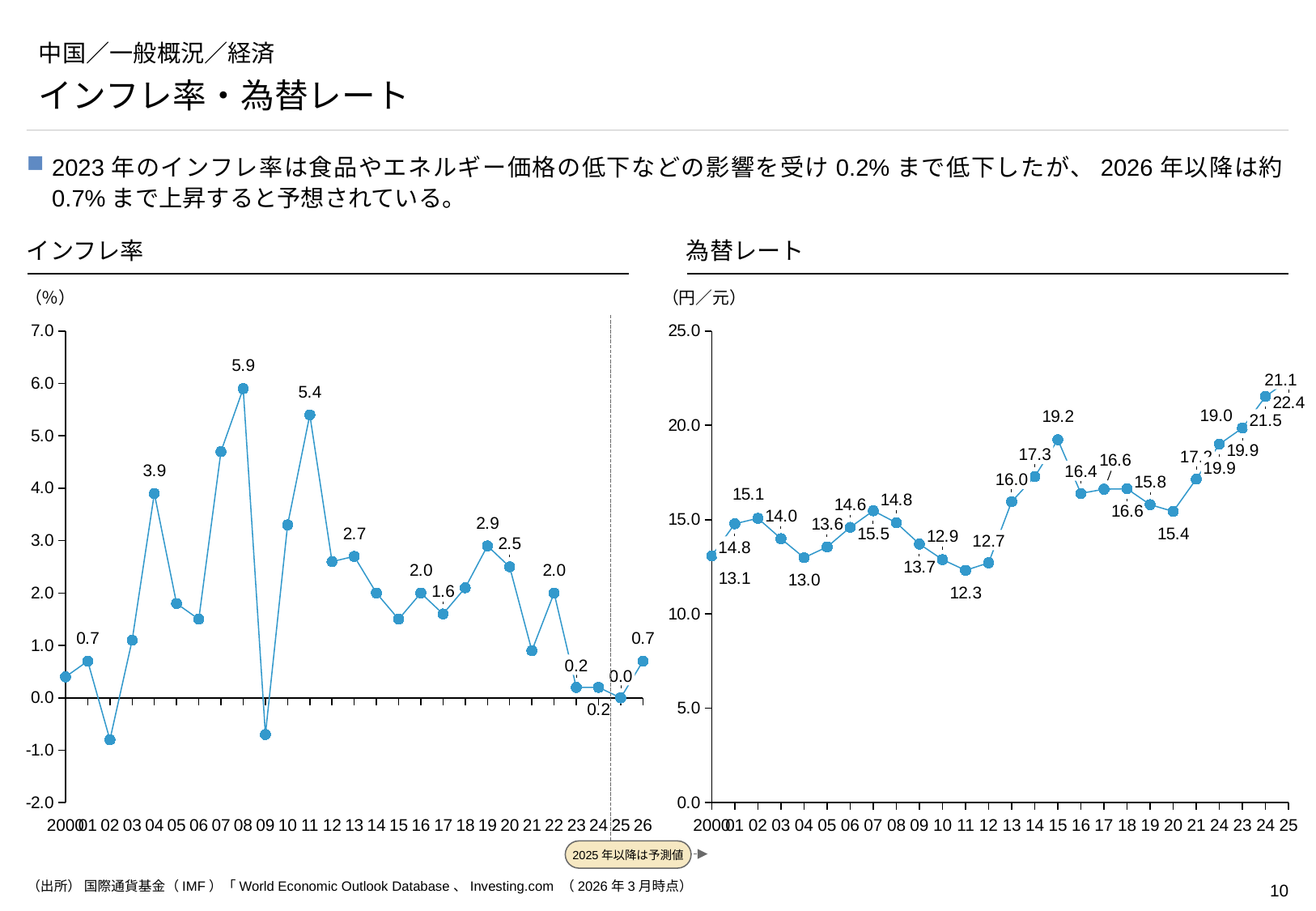
What unit is shown on the 為替レート chart's axis? 円／元 In the インフレ率 chart, which year has the larger value, 2019 or 2020? 2019 In the 為替レート chart, which year has the lowest value? 2011 In the インフレ率 chart, is the value for 2007 greater or less than 4.0? greater What kind of chart is the インフレ率 chart? line chart In the インフレ率 chart, what is the value for 2026? 0.7 In the 為替レート chart, what is the difference between the 2014 value and the 2013 value? 1.3 In the インフレ率 chart, what is the inflation rate for 2008? 5.9 In the インフレ率 chart, which year has the highest inflation rate? 2008 In the インフレ率 chart, what is the value for 2023? 0.2 In the 為替レート chart, what is the value for 2015? 19.2 In the インフレ率 chart, what is the difference between the 2008 value and the 2011 value? 0.5